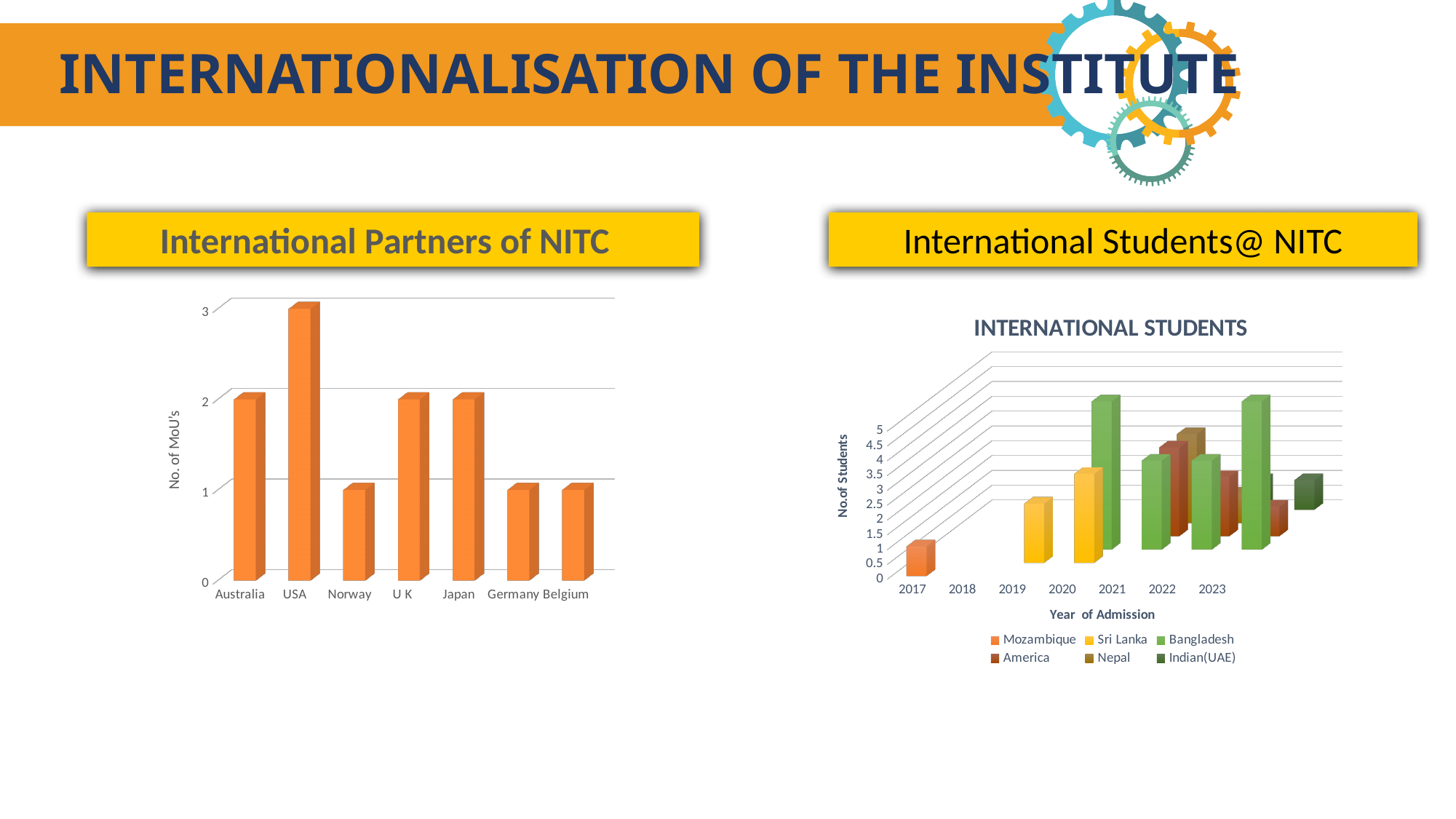
In the International Partners of NITC chart, how many MoU's does USA have? 3 How many years of admission are shown on the x axis of the INTERNATIONAL STUDENTS chart? 7 What is the x-axis label of the INTERNATIONAL STUDENTS chart? Year of Admission In the International Partners of NITC chart, what is the difference between the number of MoU's for USA and Germany? 2 In the International Partners of NITC chart, how many MoU's does Australia have? 2 In the International Partners of NITC chart, which country has the highest number of MoU's? USA What kind of chart is the International Partners of NITC chart? Bar chart In the International Partners of NITC chart, which has more MoU's, Japan or Belgium? Japan In the International Partners of NITC chart, how many MoU's does Norway have? 1 How many series does the legend of the INTERNATIONAL STUDENTS chart list? 6 How many countries are shown in the International Partners of NITC chart? 7 What is the y-axis label of the International Partners of NITC chart? No. of MoU's